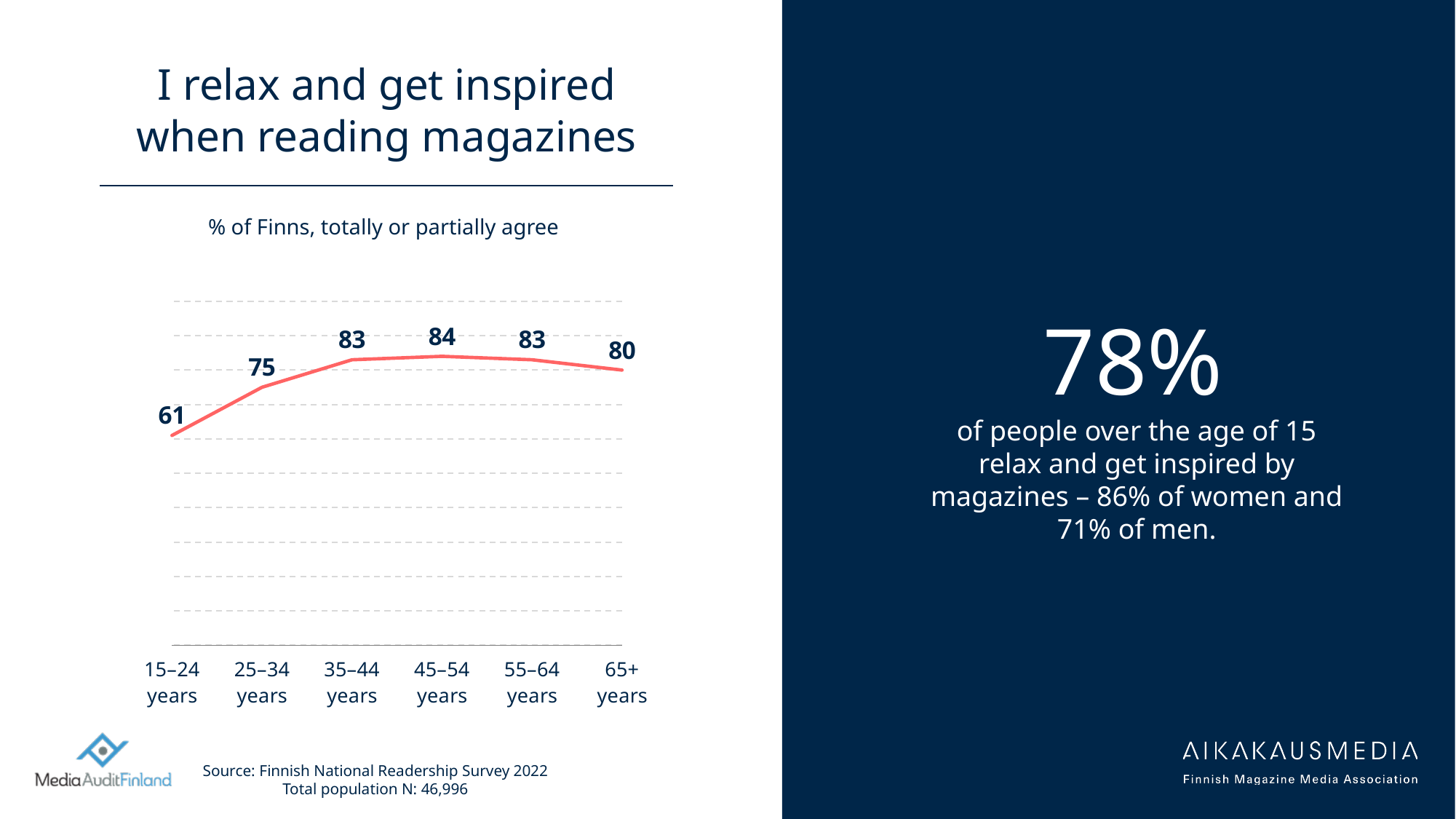
What is the difference between the values for 45–54 years and 65+ years? 4 What is the value for the 15–24 years age group? 61 What is the value for the 65+ years age group? 80 Which age group has the highest value? 45–54 years How many age groups are plotted on the chart? 6 What does the subtitle above the chart say the values represent? % of Finns, totally or partially agree Which age group has the lowest value? 15–24 years What is the value for the 45–54 years age group? 84 Which is larger, the value for 25–34 years or the value for 65+ years? 65+ years Do the values rise or fall from 15–24 years to 45–54 years? Rise What is the difference between the values for 25–34 years and 15–24 years? 14 What kind of chart is shown on the slide? Line chart